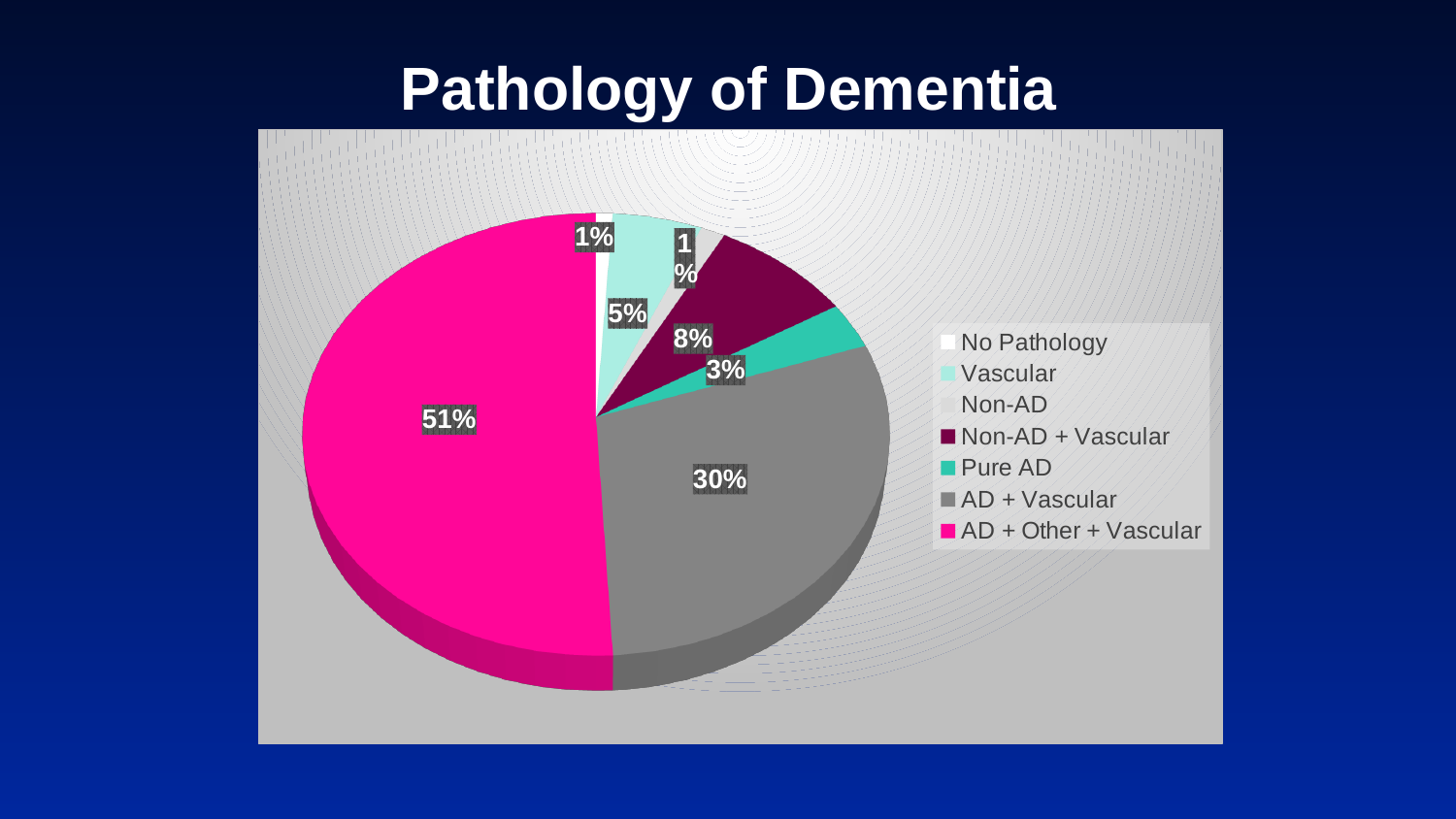
Which is larger, the Vascular slice or the Non-AD + Vascular slice? Non-AD + Vascular Which category has the largest slice of the pie? AD + Other + Vascular Which colour represents AD + Other + Vascular in the legend? pink What is the value for Non-AD + Vascular? 8% What share of the pie is AD + Vascular? 30% What is the title of the chart? Pathology of Dementia How many categories does the legend list? 7 What kind of chart is shown on the slide? pie chart What is the value for Pure AD? 3% What is the value for Vascular? 5% What share of the pie is AD + Other + Vascular? 51% What is the difference between the AD + Other + Vascular slice and the AD + Vascular slice? 21%